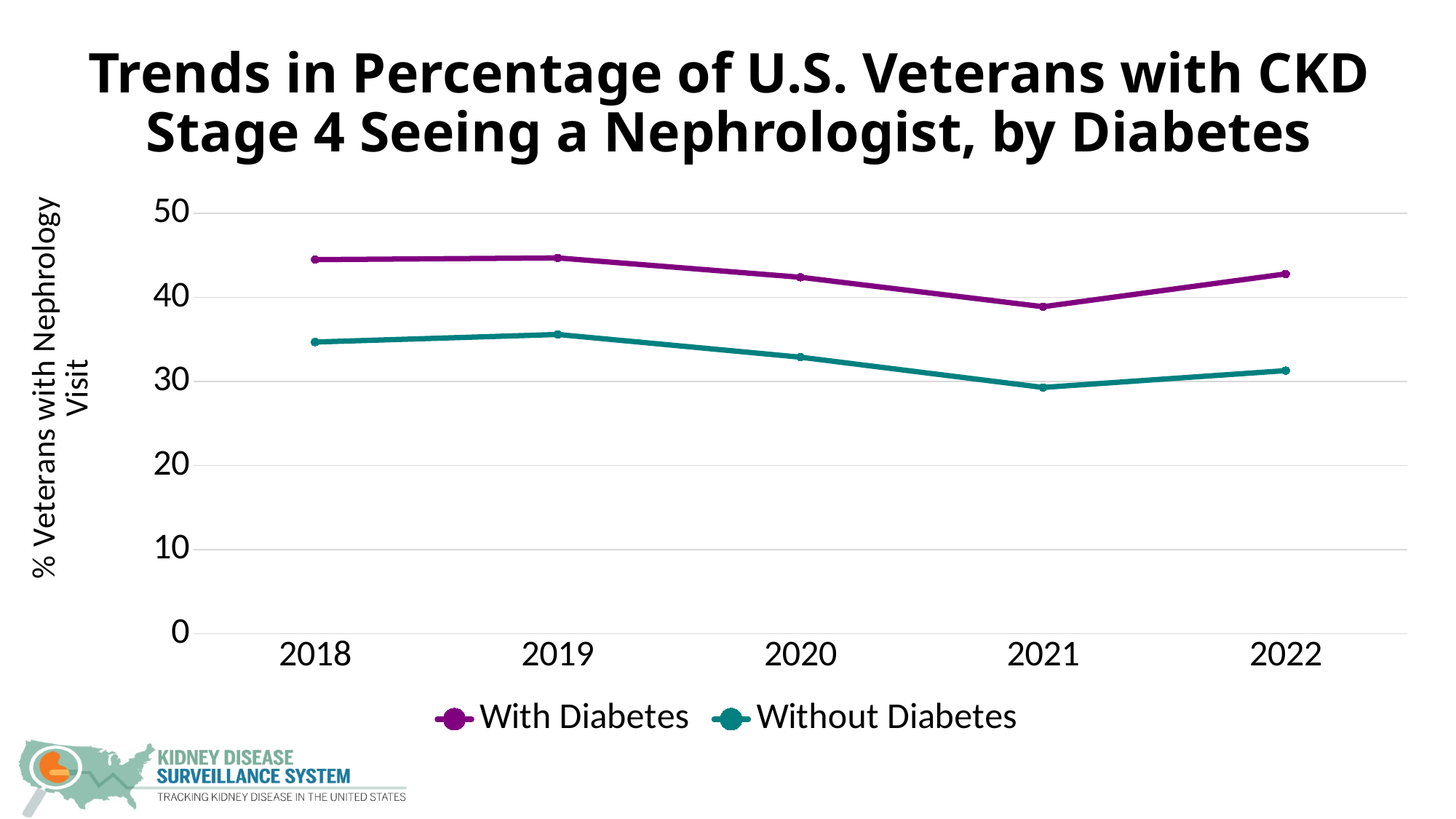
What is the label of the y axis? % Veterans with Nephrology Visit Is the value for With Diabetes in 2018 greater or less than 40? greater Does the With Diabetes series rise or fall from 2019 to 2021? fall How many years are plotted along the x axis? 5 Is the value for Without Diabetes in 2019 greater or less than 30? greater What kind of chart is shown on the slide? line chart Is the value for With Diabetes in 2021 greater or less than 40? less In which year is the Without Diabetes series at its highest? 2019 Which series has the higher value in 2020, With Diabetes or Without Diabetes? With Diabetes In which year is the With Diabetes series at its lowest? 2021 How many series does the legend list? 2